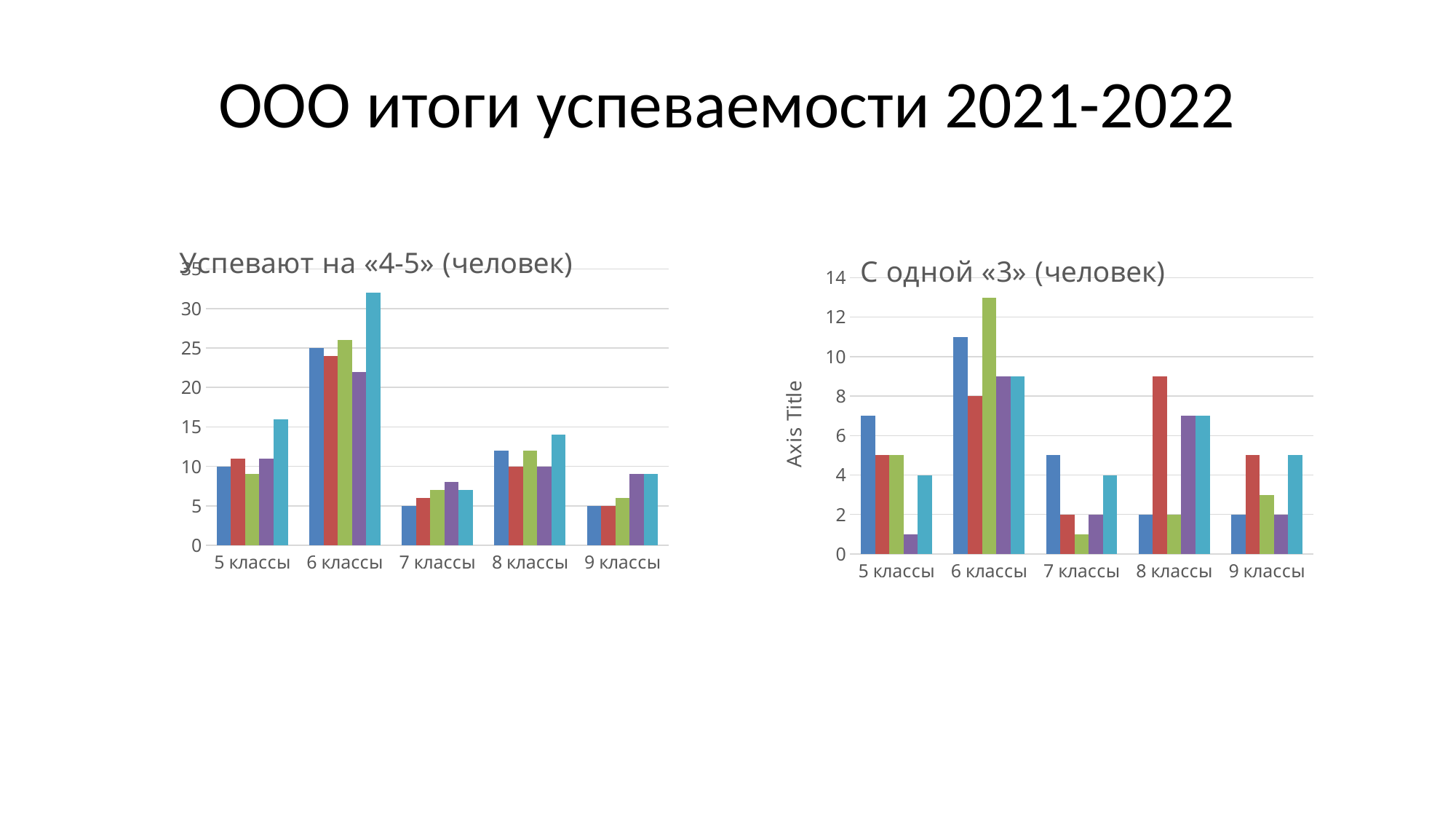
How many categories are shown on the x axis of the right chart, "С одной «3» (человек)"? 5 In the left chart, "Успевают на «4-5» (человек)", is the tallest bar for 7 классы greater or less than 10? less In the right chart, "С одной «3» (человек)", is the red bar for 8 классы greater or less than 8? greater In the left chart, "Успевают на «4-5» (человек)", which category has the tallest bar? 6 классы In the right chart, "С одной «3» (человек)", is the tallest bar for 6 классы greater or less than 12? greater In the left chart, "Успевают на «4-5» (человек)", what is the value of the blue bar for 5 классы? 10 What kind of chart is the left chart, "Успевают на «4-5» (человек)"? bar chart What is the vertical axis title shown on the right chart, "С одной «3» (человек)"? Axis Title In the right chart, "С одной «3» (человек)", which category contains the tallest bar? 6 классы In the left chart, "Успевают на «4-5» (человек)", which is larger: the tallest bar for 6 классы or the tallest bar for 8 классы? 6 классы In the right chart, "С одной «3» (человек)", what is the value of the red bar for 6 классы? 8